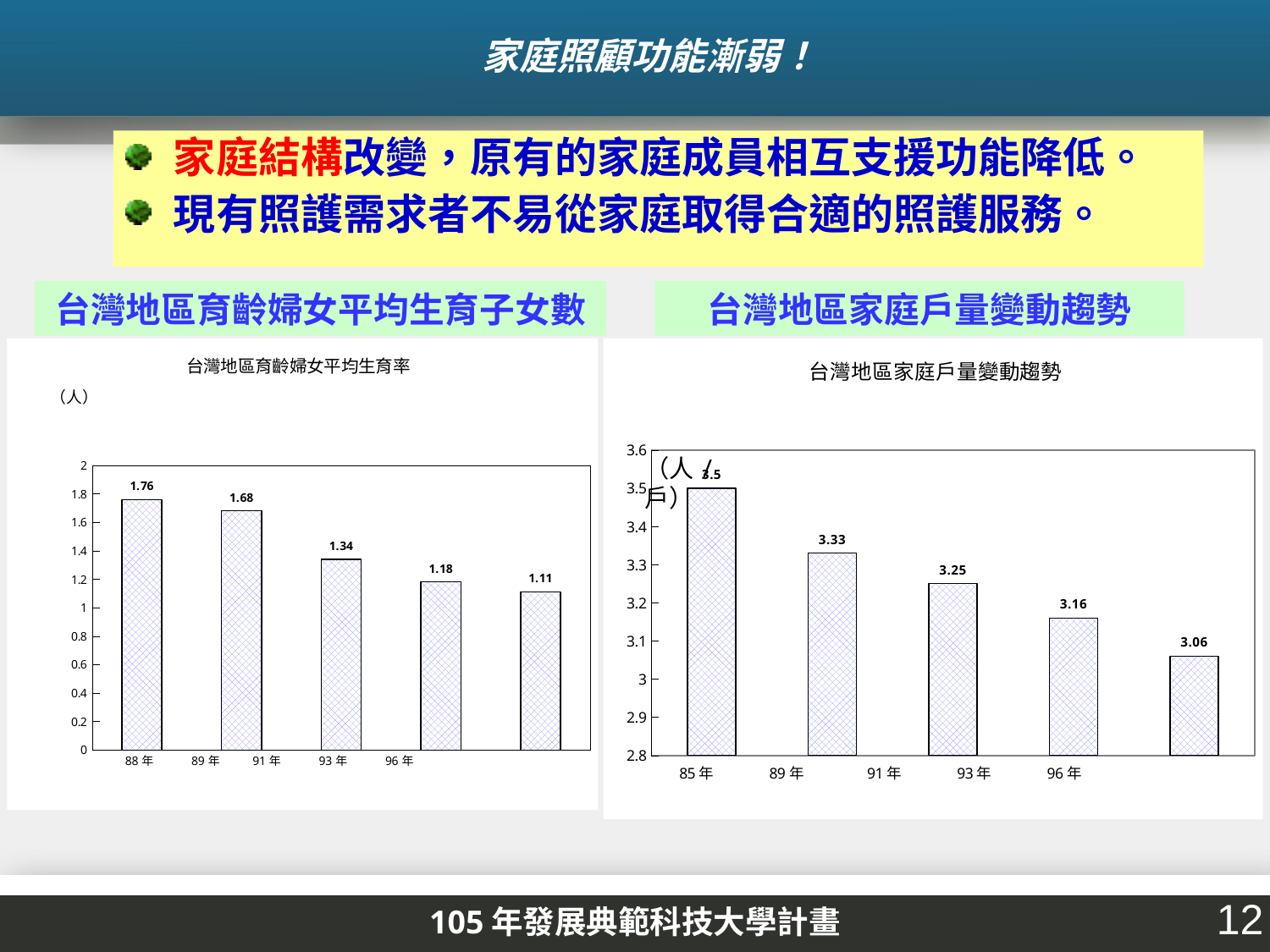
In the left chart (台灣地區育齡婦女平均生育率), what is the lowest value shown? 1.11 What type of chart is the 台灣地區育齡婦女平均生育率 chart on the left? bar chart In the left chart (台灣地區育齡婦女平均生育率), what is the value of the first bar (88 年)? 1.76 In the left chart (台灣地區育齡婦女平均生育率), what is the difference between the first bar (1.76) and the last bar (1.11)? 0.65 In the right chart (台灣地區家庭戶量變動趨勢), which is larger, the second bar (3.33) or the third bar (3.25)? 3.33 In the left chart (台灣地區育齡婦女平均生育率), how many bars are plotted? 5 In the right chart (台灣地區家庭戶量變動趨勢), do the values rise or fall from left to right? fall In the left chart (台灣地區育齡婦女平均生育率), do the values rise or fall from left to right? fall In the left chart (台灣地區育齡婦女平均生育率), what is the highest value shown? 1.76 In the right chart (台灣地區家庭戶量變動趨勢), what is the lowest value shown? 3.06 In the right chart (台灣地區家庭戶量變動趨勢), how many bars are plotted? 5 In the right chart (台灣地區家庭戶量變動趨勢), what is the value for 85 年? 3.5